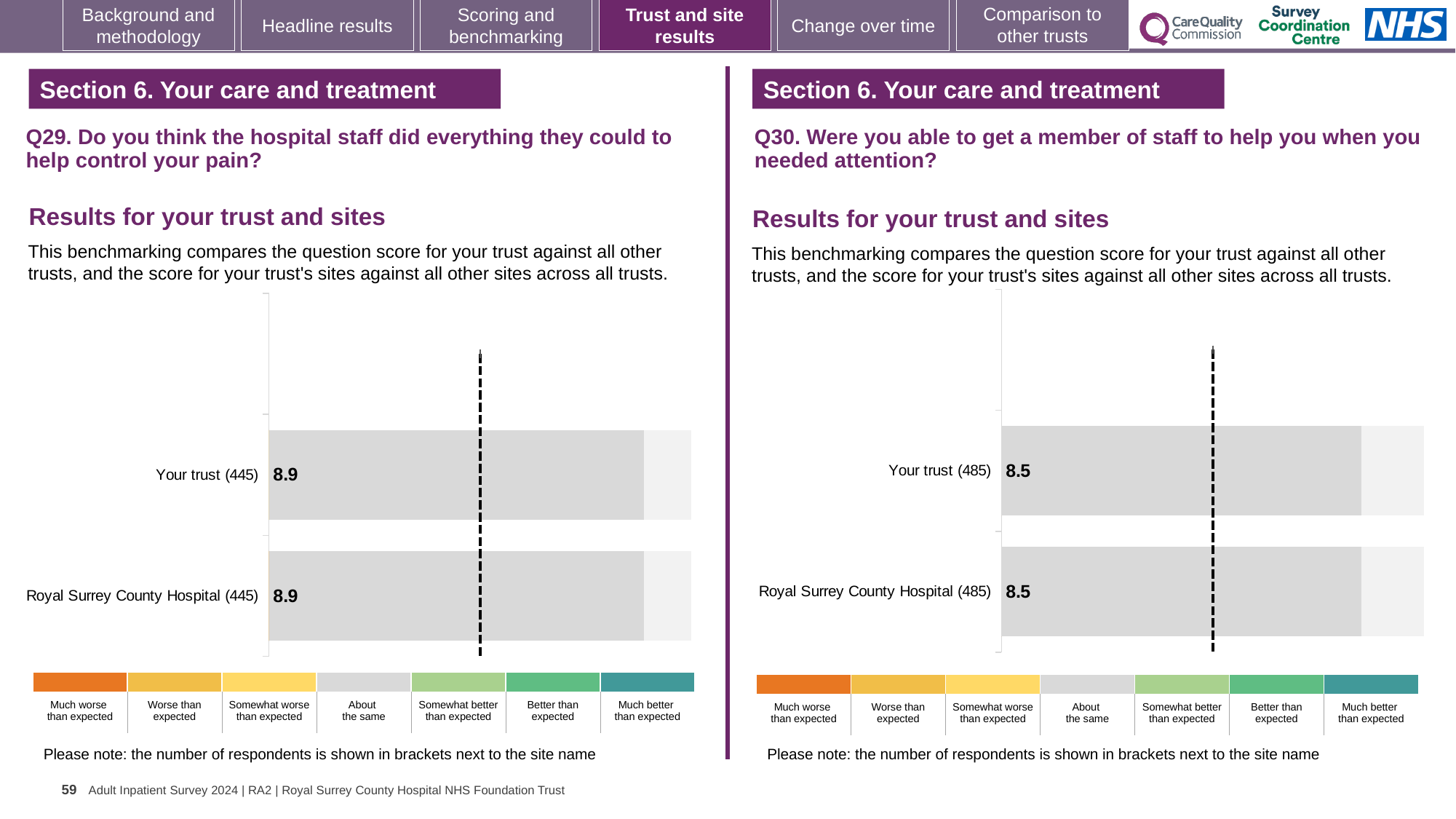
On the Q29 chart (left), what is the difference between the score for Your trust and the score for Royal Surrey County Hospital? 0 On the Q30 chart (right), how many respondents are shown in brackets for Royal Surrey County Hospital? 485 How many benchmark categories are shown in the colour key below the Q29 chart (left)? 7 How many bars are plotted on the Q30 chart (right)? 2 On the Q30 chart (right), what is the score for Royal Surrey County Hospital? 8.5 On the Q29 chart (left), what is the score for Your trust? 8.9 On the Q29 chart (left), how many respondents are shown in brackets for Your trust? 445 On the Q29 chart (left), what is the score for Royal Surrey County Hospital? 8.9 Which chart shows a higher score for Your trust, the Q29 chart (left) or the Q30 chart (right)? Q29 chart (left) On the Q30 chart (right), what is the score for Your trust? 8.5 What is the difference between the Your trust score on the Q29 chart (left) and the Your trust score on the Q30 chart (right)? 0.4 What type of chart is used on the Q29 chart (left)? Bar chart